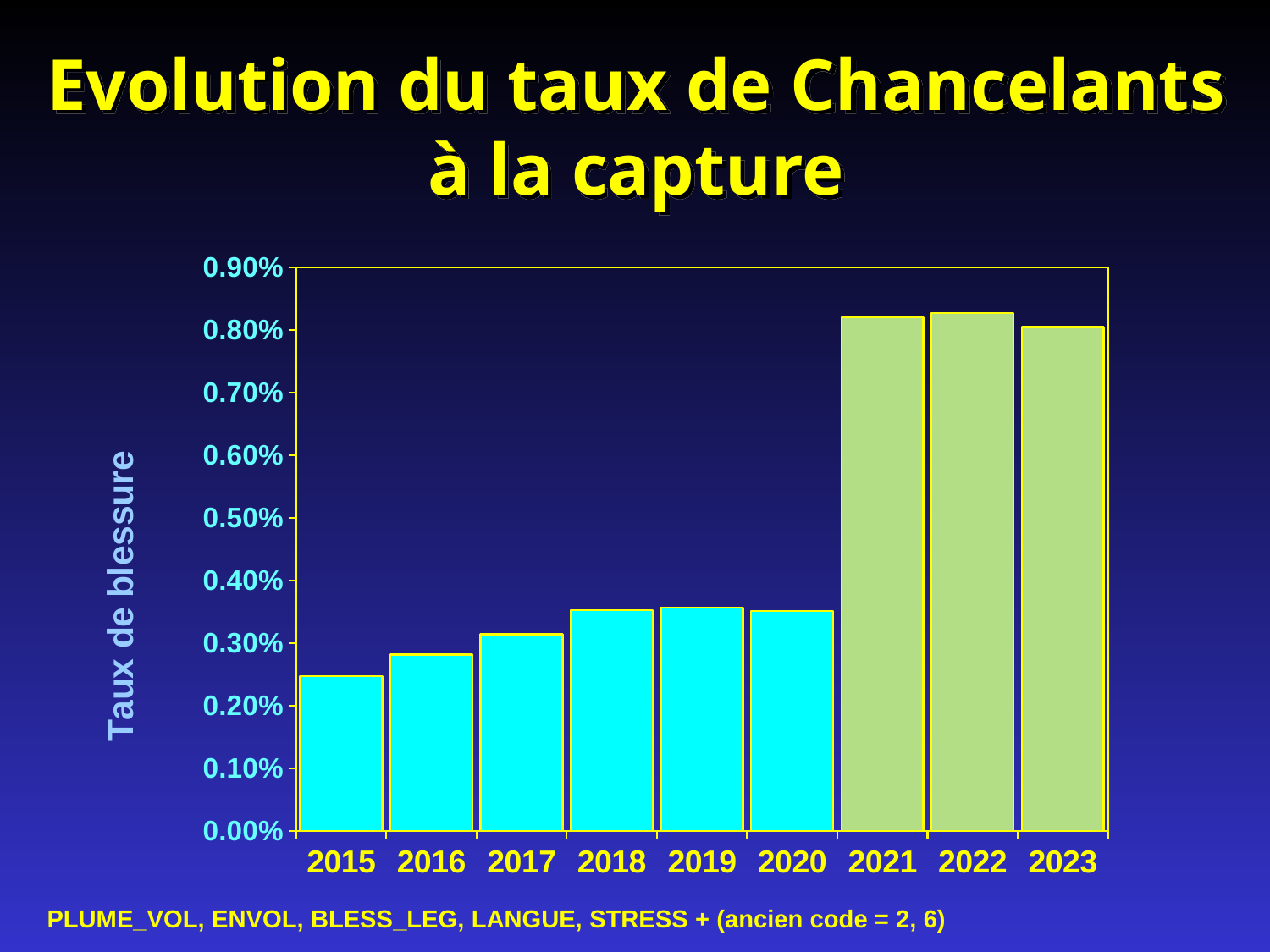
What is the title of the vertical axis of the chart? Taux de blessure Is the value for 2018 greater or less than 0.30%? greater How many years are shown on the x axis of the chart? 9 What kind of chart is shown on the slide? bar chart Which is larger, the value for 2015 or the value for 2016? 2016 Is the value for 2023 greater or less than 0.70%? greater Is the value for 2015 greater or less than 0.30%? less Which is larger, the value for 2020 or the value for 2021? 2021 Do the values rise or fall from 2015 to 2019? rise Which year has the lowest value in the chart? 2015